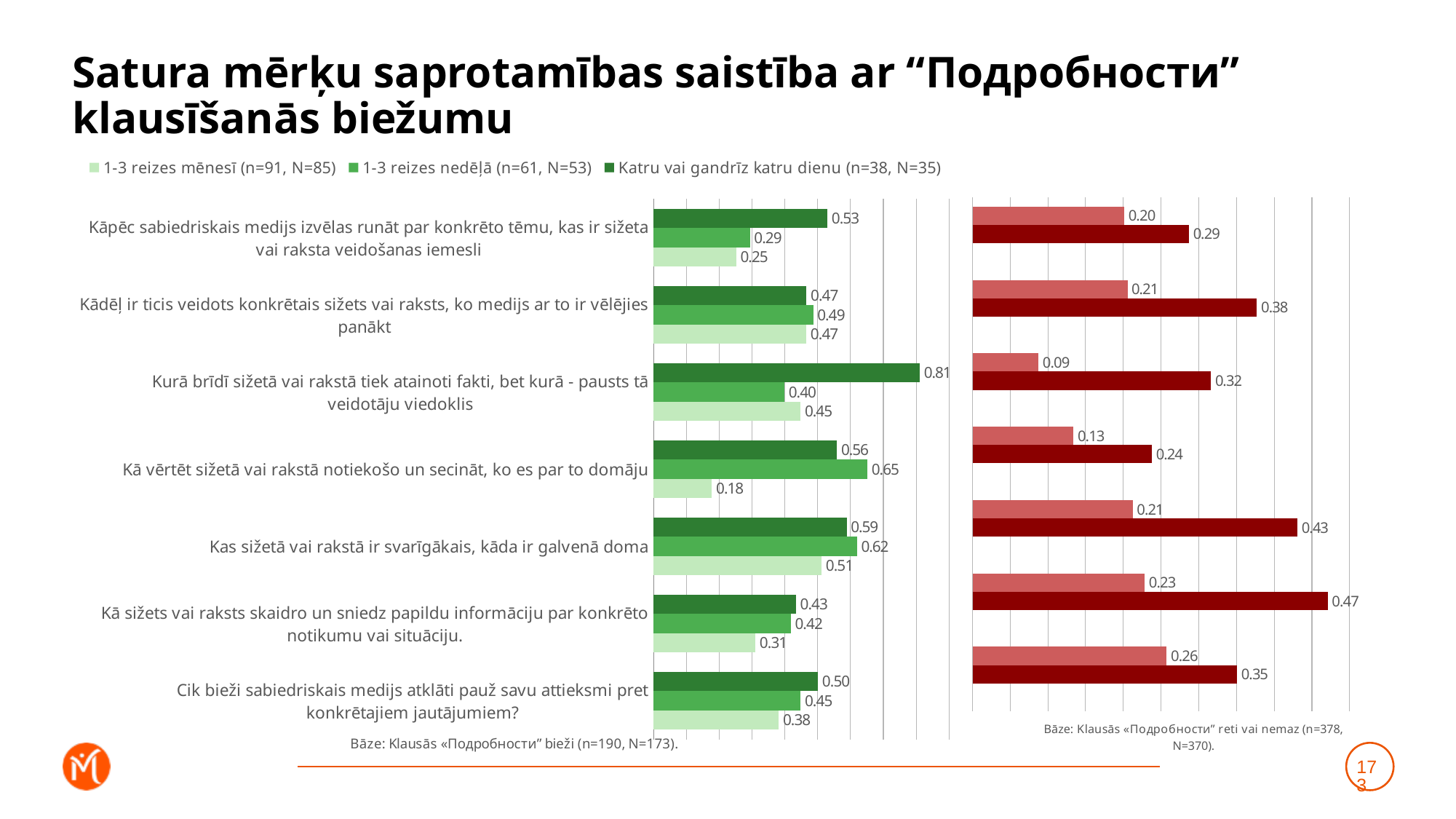
In the left (green) chart, which category has the lowest value for the "1-3 reizes mēnesī" series? Kā vērtēt sižetā vai rakstā notiekošo un secināt, ko es par to domāju In the left (green) chart, for "Kā vērtēt sižetā vai rakstā notiekošo un secināt, ko es par to domāju", which is larger: the "1-3 reizes nedēļā" value or the "Katru vai gandrīz katru dienu" value? 1-3 reizes nedēļā What base (Bāze) note is printed under the left (green) chart? Bāze: Klausās «Подробности» bieži (n=190, N=173). How many categories are shown in the left (green) chart? 7 How many series does the legend list for the left (green) chart? 3 In the left (green) chart, what is the value for "Katru vai gandrīz katru dienu" for the category "Kurā brīdī sižetā vai rakstā tiek atainoti fakti, bet kurā - pausts tā veidotāju viedoklis"? 0.81 In the left (green) chart, what is the value for "1-3 reizes mēnesī" for the category "Kā vērtēt sižetā vai rakstā notiekošo un secināt, ko es par to domāju"? 0.18 In the right (red) chart, what is the value of the dark red bar for "Kā sižets vai raksts skaidro un sniedz papildu informāciju par konkrēto notikumu vai situāciju."? 0.47 What type of chart is the left (green) chart? Bar chart In the left (green) chart, what is the value for "1-3 reizes nedēļā" for the category "Kas sižetā vai rakstā ir svarīgākais, kāda ir galvenā doma"? 0.62 In the left (green) chart, what is the difference between the "Katru vai gandrīz katru dienu" and "1-3 reizes mēnesī" values for "Kāpēc sabiedriskais medijs izvēlas runāt par konkrēto tēmu, kas ir sižeta vai raksta veidošanas iemesli"? 0.28 In the left (green) chart, which category has the highest value for the "Katru vai gandrīz katru dienu" series? Kurā brīdī sižetā vai rakstā tiek atainoti fakti, bet kurā - pausts tā veidotāju viedoklis